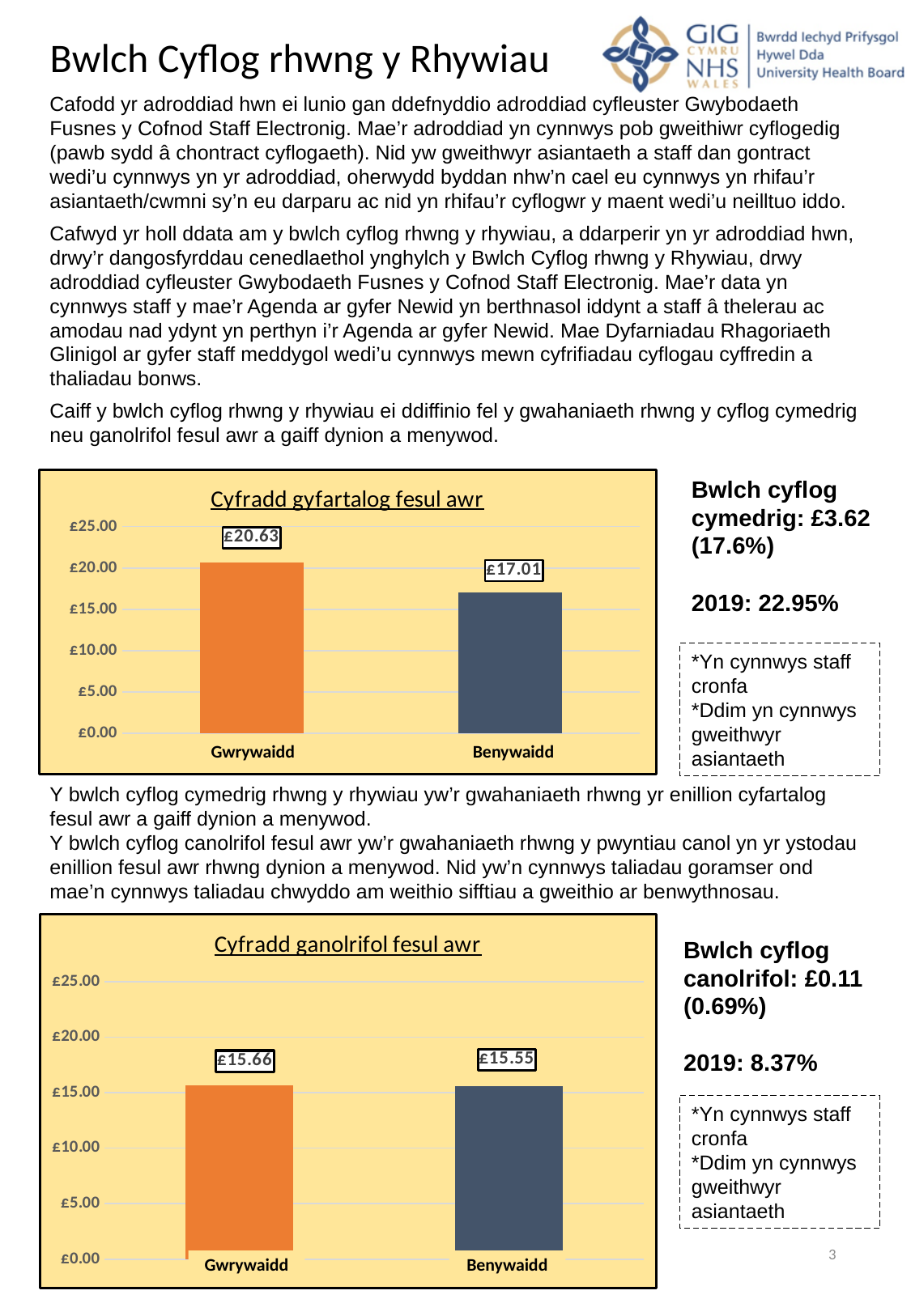
What kind of chart is the chart titled "Cyfradd gyfartalog fesul awr"? bar chart In the chart titled "Cyfradd gyfartalog fesul awr", what is the value for Gwrywaidd? £20.63 In the chart titled "Cyfradd ganolrifol fesul awr", what is the difference between the Gwrywaidd and Benywaidd values? £0.11 In the chart titled "Cyfradd gyfartalog fesul awr", what is the difference between the Gwrywaidd and Benywaidd values? £3.62 How many categories are shown in the chart titled "Cyfradd ganolrifol fesul awr"? 2 In the chart titled "Cyfradd gyfartalog fesul awr", what colour is the Gwrywaidd bar? orange In the chart titled "Cyfradd ganolrifol fesul awr", what is the value for Benywaidd? £15.55 In the chart titled "Cyfradd ganolrifol fesul awr", is the value for Gwrywaidd greater or less than £20.00? less In the chart titled "Cyfradd gyfartalog fesul awr", which category has the higher value? Gwrywaidd In the chart titled "Cyfradd ganolrifol fesul awr", what is the value for Gwrywaidd? £15.66 In the chart titled "Cyfradd gyfartalog fesul awr", is the value for Benywaidd greater or less than £20.00? less In the chart titled "Cyfradd gyfartalog fesul awr", what is the value for Benywaidd? £17.01